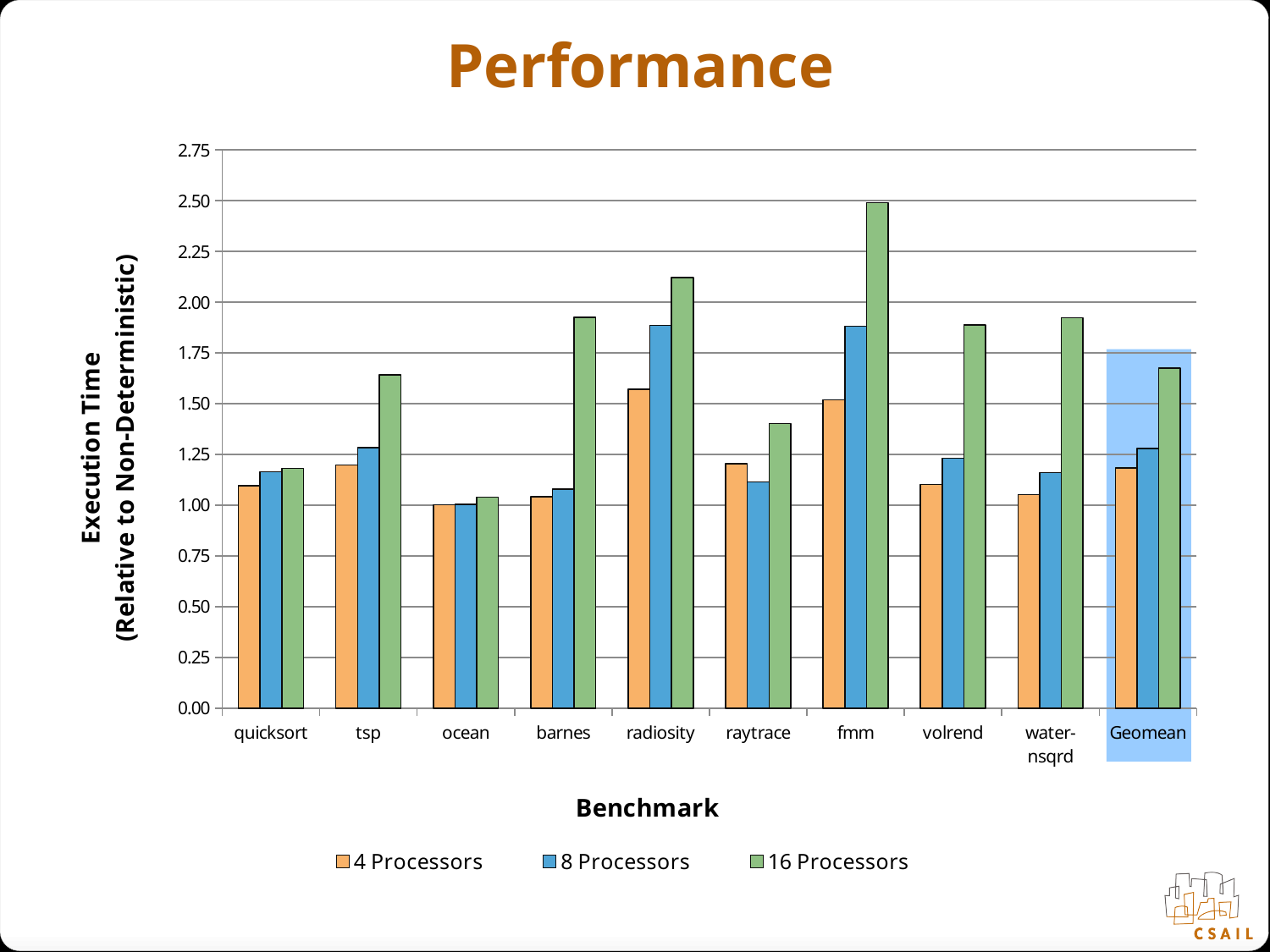
Which is larger: the 16 Processors value for fmm or for radiosity? fmm For raytrace, which is larger: the 4 Processors value or the 8 Processors value? 4 Processors Is the 16 Processors value for fmm greater or less than 2.25? greater Is the 8 Processors value for Geomean greater or less than 1.50? less Is the 16 Processors value for tsp greater or less than 1.75? less How many series does the legend list? 3 How many benchmark categories are shown on the x axis? 10 Which benchmark has the lowest 16 Processors value? ocean Which benchmark has the highest 16 Processors value? fmm What kind of chart is shown on the slide? bar chart What is the title of the x axis? Benchmark